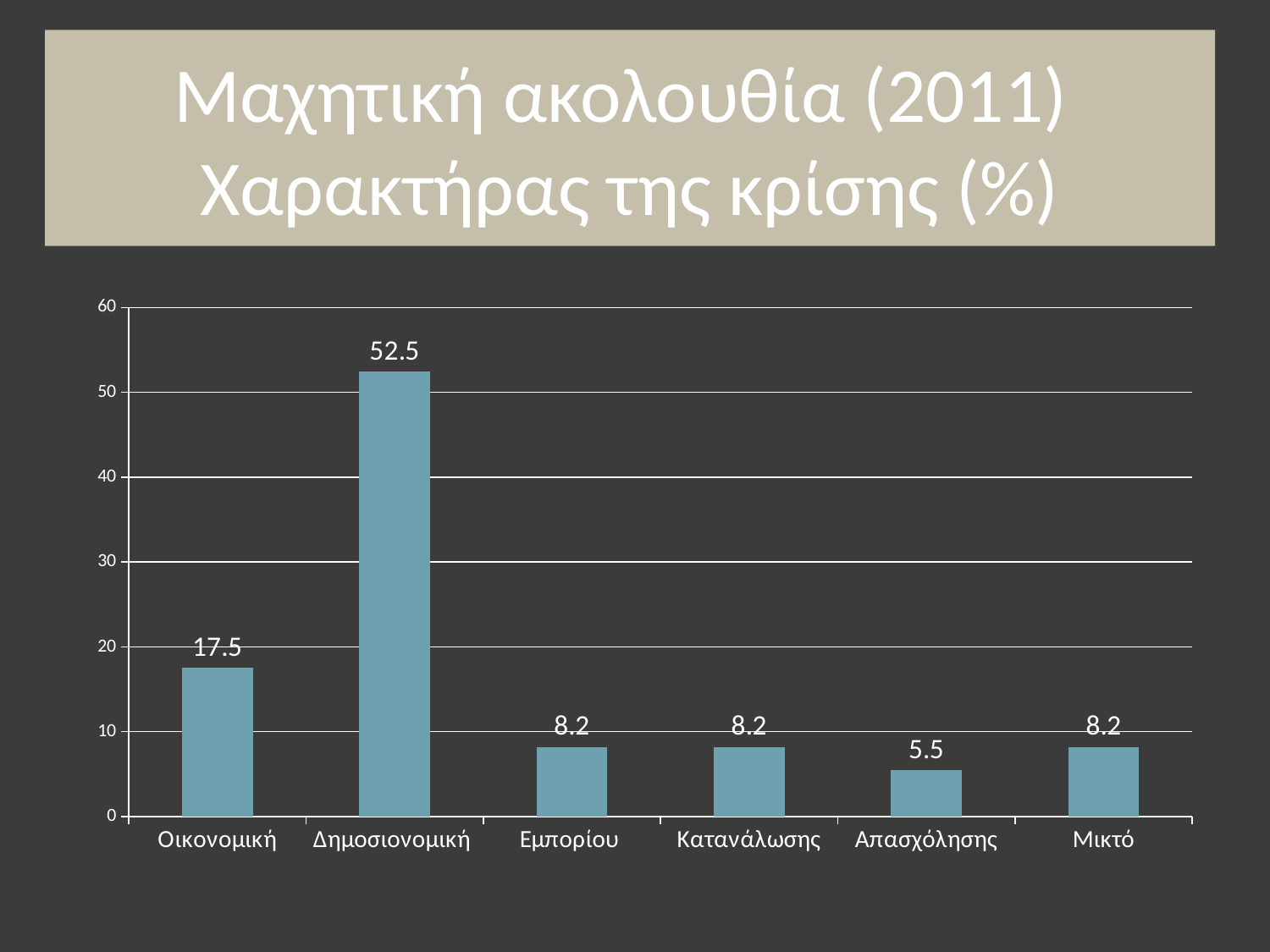
What is the value for Μικτό? 8.2 What is the difference between the values for Δημοσιονομική and Οικονομική? 35 Which category has the highest value? Δημοσιονομική Is the value for Δημοσιονομική greater or less than 50? greater Which category has the lowest value? Απασχόλησης What is the value for Οικονομική? 17.5 What is the value for Δημοσιονομική? 52.5 What is the difference between the values for Εμπορίου and Απασχόλησης? 2.7 What kind of chart is shown on the slide? bar chart How many categories are shown on the x axis? 6 What is the value for Απασχόλησης? 5.5 Which is larger, the value for Οικονομική or the value for Κατανάλωσης? Οικονομική